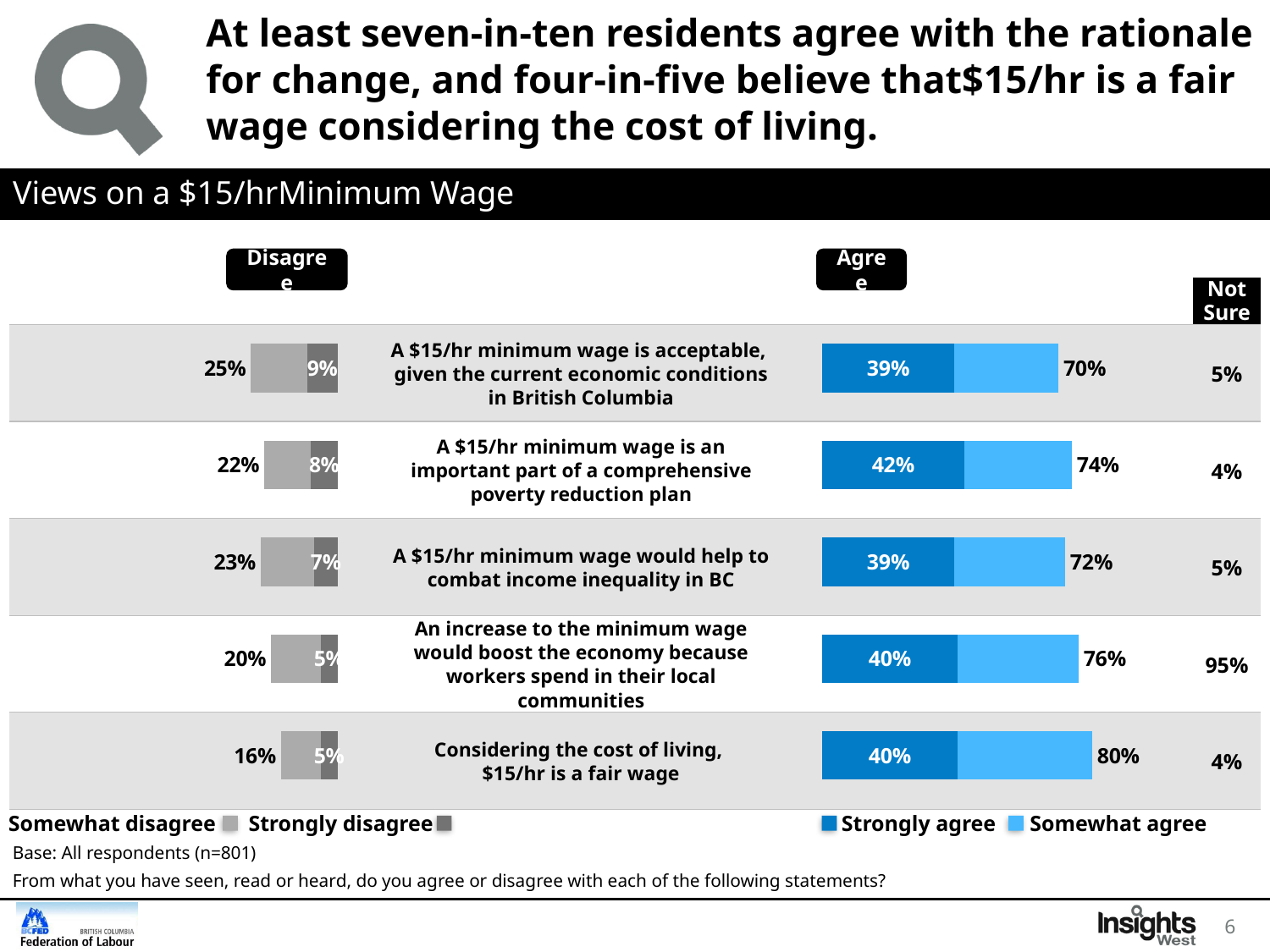
What is the Not Sure percentage for the statement that a $15/hr minimum wage is an important part of a comprehensive poverty reduction plan? 4% What percentage of residents agree that, considering the cost of living, $15/hr is a fair wage? 80% What type of chart is used to show the views on a $15/hr minimum wage? Stacked bar chart How many statements are shown in the chart? 5 What is the total disagree percentage for the statement that a $15/hr minimum wage is acceptable given the current economic conditions in British Columbia? 25% How many response categories are listed in the legends below the chart? 4 What percentage strongly agree that a $15/hr minimum wage is an important part of a comprehensive poverty reduction plan? 42% What is the difference between the total agree percentage for 'Considering the cost of living, $15/hr is a fair wage' and for 'A $15/hr minimum wage is acceptable, given the current economic conditions in British Columbia'? 10% Which is larger: the total disagree percentage for the poverty reduction plan statement or for the income inequality statement? Income inequality statement (23%) Which statement has the lowest total agree percentage? A $15/hr minimum wage is acceptable, given the current economic conditions in British Columbia Which statement has the highest total agree percentage? Considering the cost of living, $15/hr is a fair wage What percentage strongly disagree that a $15/hr minimum wage would help to combat income inequality in BC? 7%